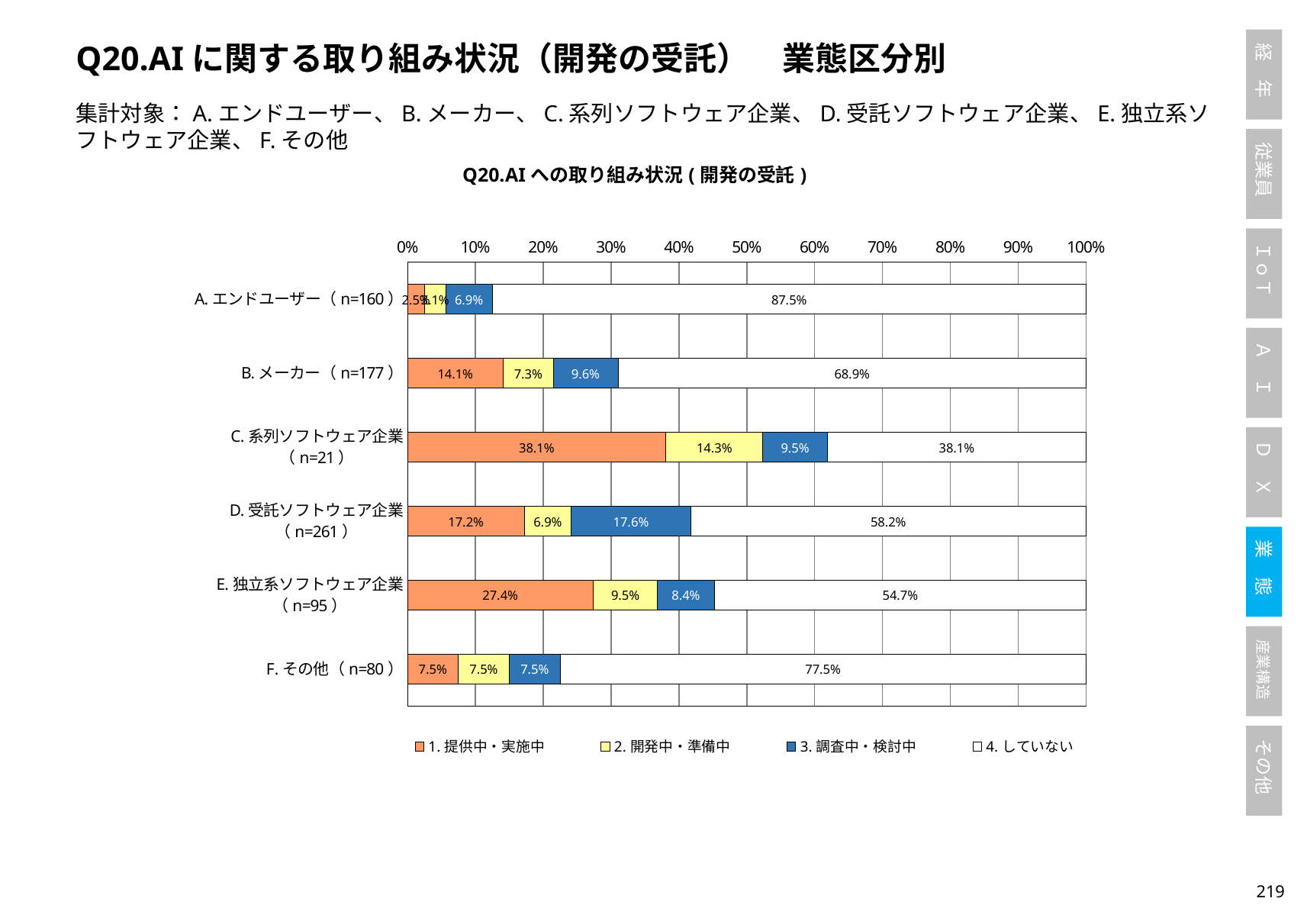
Which is larger: the 「1. 提供中・実施中」 value for E. 独立系ソフトウェア企業 or for D. 受託ソフトウェア企業? E. 独立系ソフトウェア企業 How many categories (business types) are plotted on the chart? 6 What is the difference between the 「4. していない」 values for B. メーカー and E. 独立系ソフトウェア企業? 14.2% What type of chart is shown on the slide? Stacked bar chart What is the value of 「1. 提供中・実施中」 for C. 系列ソフトウェア企業 (n=21)? 38.1% Which category has the lowest value for 「4. していない」? C. 系列ソフトウェア企業 (n=21) What is the title of the chart? Q20.AI への取り組み状況 ( 開発の受託 ) How many series does the legend list? 4 What is the value of 「3. 調査中・検討中」 for D. 受託ソフトウェア企業 (n=261)? 17.6% Which category has the highest value for 「1. 提供中・実施中」? C. 系列ソフトウェア企業 (n=21) What is the value of 「2. 開発中・準備中」 for B. メーカー (n=177)? 7.3% What is the value of 「4. していない」 for A. エンドユーザー (n=160)? 87.5%